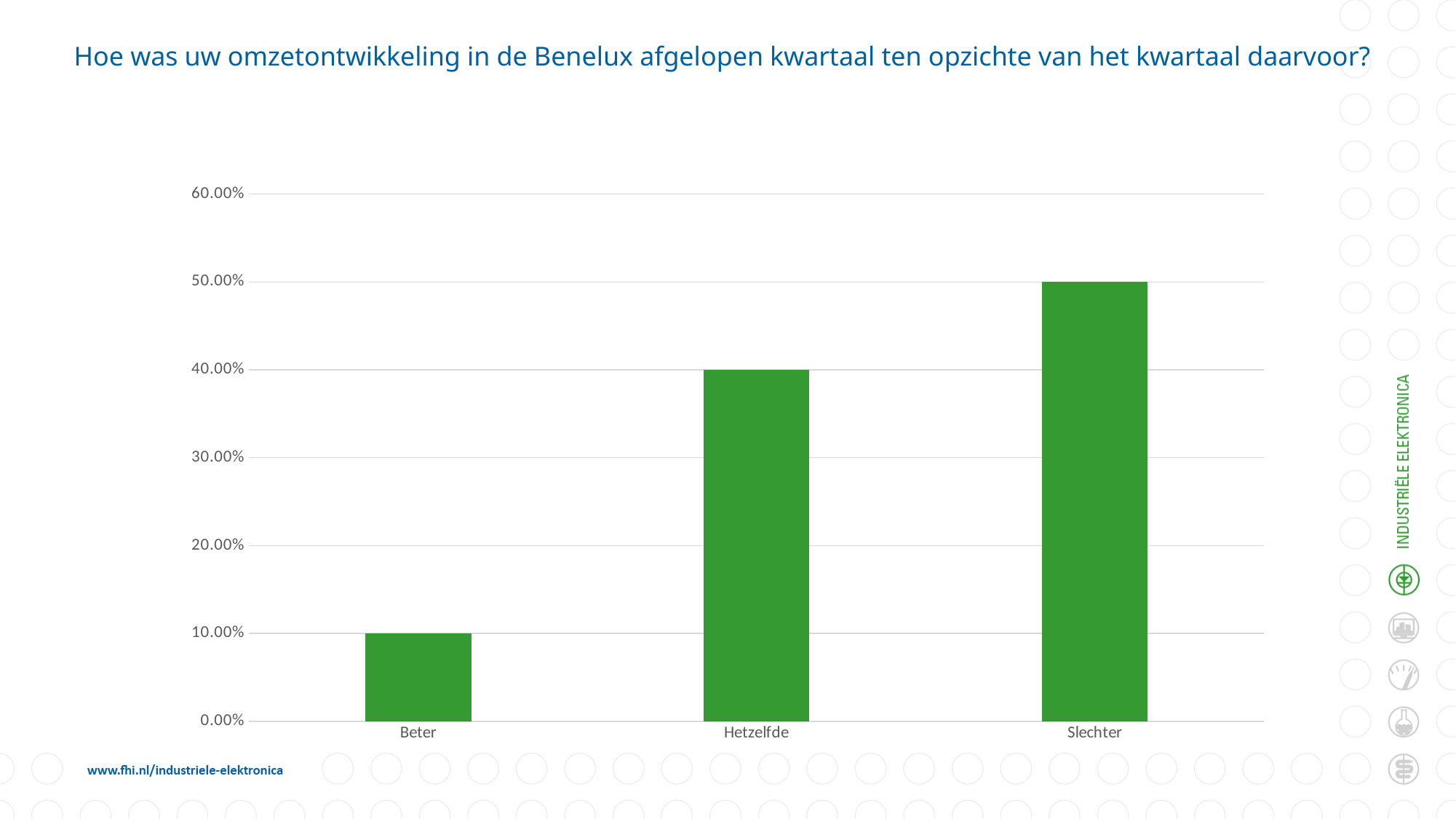
Which category has the lowest value? Beter What is the value for Beter? 10.00% Which is larger, the value for Beter or the value for Hetzelfde? Hetzelfde How many categories are shown on the x axis? 3 What is the difference between the values for Hetzelfde and Beter? 30.00% What is the difference between the values for Slechter and Hetzelfde? 10.00% Which category has the highest value? Slechter What is the value for Slechter? 50.00% Do the values rise or fall from Beter to Slechter along the x axis? rise What kind of chart is shown on the slide? bar chart Is the value for Slechter greater or less than 30.00%? greater What is the value for Hetzelfde? 40.00%